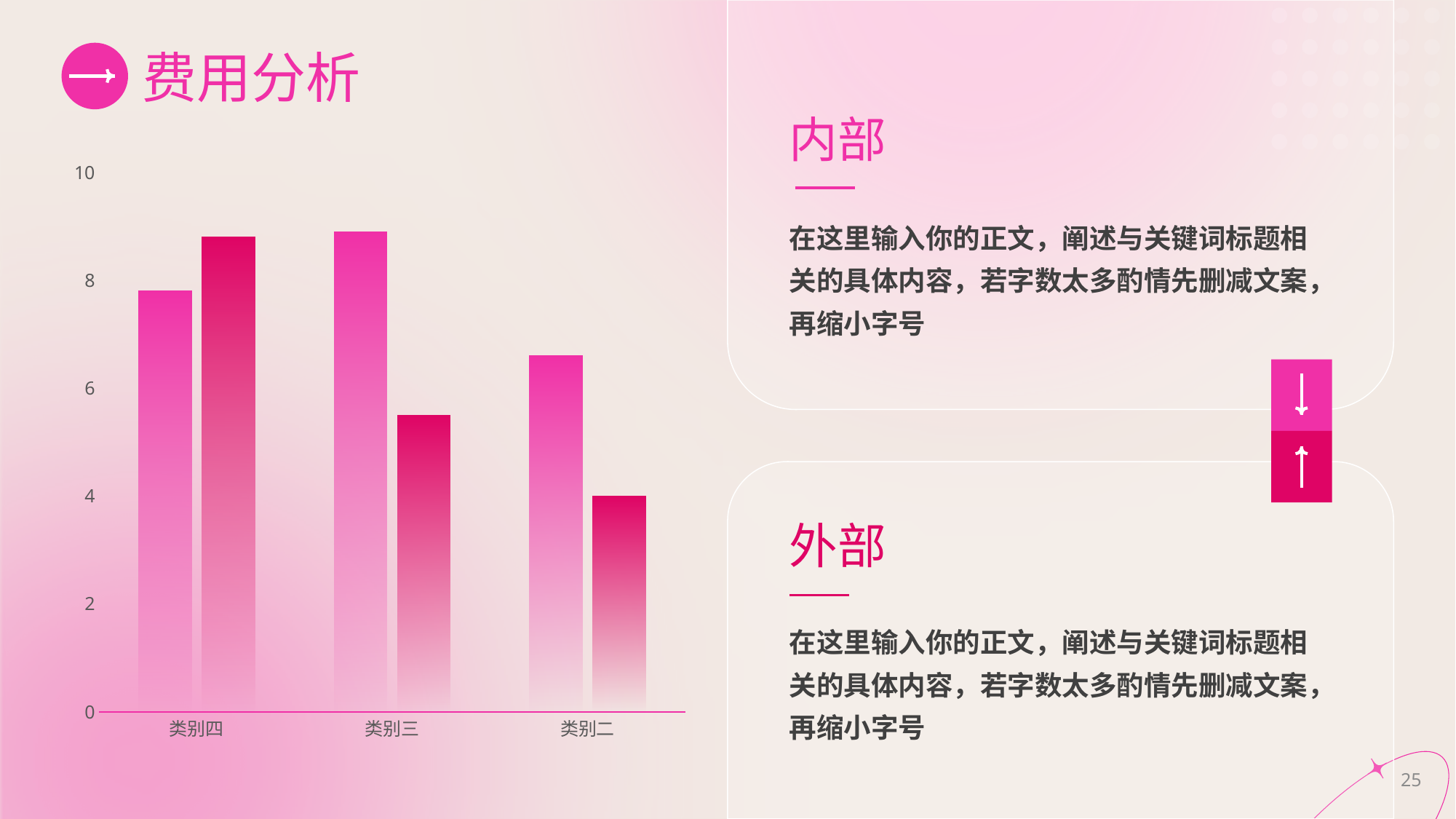
What kind of chart is shown on the slide? bar chart For 类别三, which bar is taller, the lighter pink bar or the darker pink bar? the lighter pink bar For 类别四, which bar is taller, the lighter pink bar or the darker pink bar? the darker pink bar How many categories are shown on the x axis of the chart? 3 What is the title of the slide containing the chart? 费用分析 How many bars are plotted in the chart in total? 6 Do the darker pink bars rise or fall from left to right across the categories? fall Which category has the tallest darker pink bar? 类别四 Is the value of the darker pink bar for 类别四 greater or less than 8? greater Is the value of the darker pink bar for 类别二 greater or less than 6? less Is the value of the darker pink bar for 类别三 greater or less than 6? less